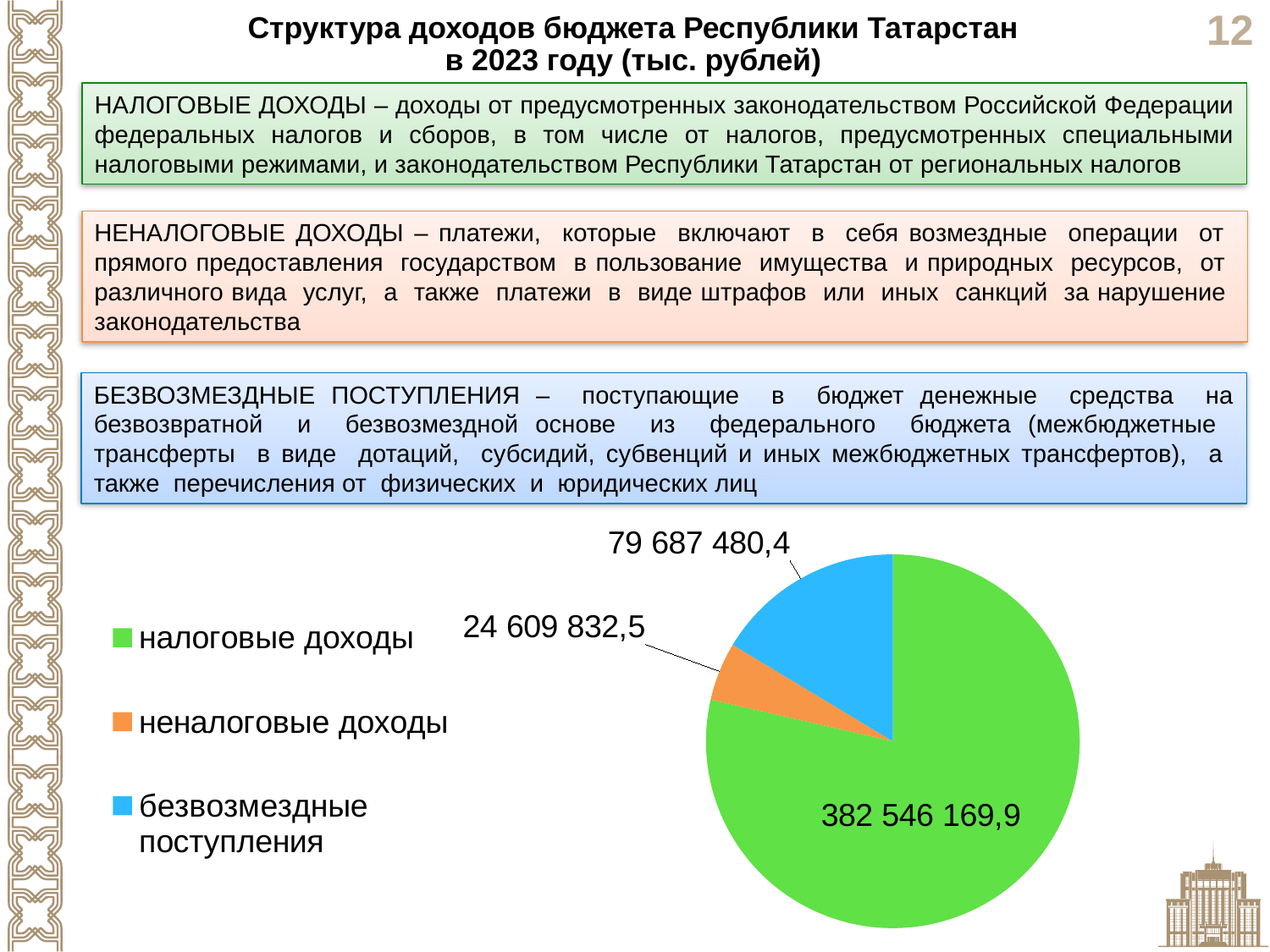
What is the difference between безвозмездные поступления and неналоговые доходы? 55 077 647,9 What is the value for неналоговые доходы in the pie chart? 24 609 832,5 What colour is the slice for безвозмездные поступления? blue Which is larger: безвозмездные поступления or неналоговые доходы? безвозмездные поступления What is the difference between налоговые доходы and безвозмездные поступления? 302 858 689,5 What is the value for налоговые доходы in the pie chart? 382 546 169,9 Which category has the largest slice in the pie chart? налоговые доходы How many slices does the pie chart have? 3 What is the title of the slide containing the chart? Структура доходов бюджета Республики Татарстан в 2023 году (тыс. рублей) What is the value for безвозмездные поступления in the pie chart? 79 687 480,4 Which category has the smallest slice in the pie chart? неналоговые доходы What type of chart is shown on the slide? pie chart